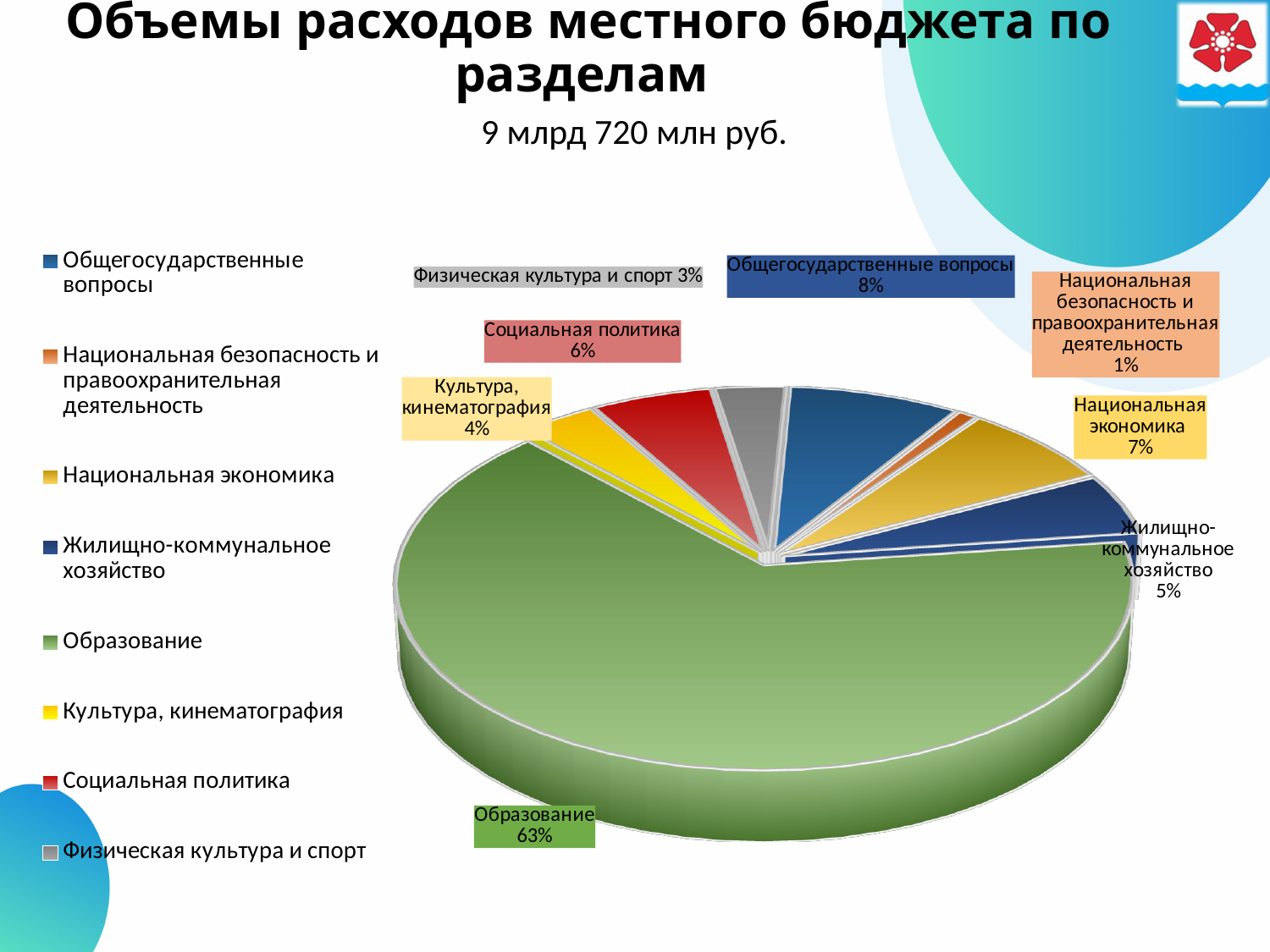
What kind of chart is shown on the slide? pie chart What is the value shown for Национальная экономика? 7% What share of the pie does Образование have? 63% Which category has the smallest slice of the pie? Национальная безопасность и правоохранительная деятельность What is the value shown for Общегосударственные вопросы? 8% Which is larger: the share of Общегосударственные вопросы or the share of Культура, кинематография? Общегосударственные вопросы What is the value shown for Жилищно-коммунальное хозяйство? 5% What is the difference between the shares of Социальная политика and Физическая культура и спорт? 3% What total amount is stated under the chart title? 9 млрд 720 млн руб. How many categories does the pie chart have? 8 Which category has the largest slice of the pie? Образование What is the value shown for Национальная безопасность и правоохранительная деятельность? 1%